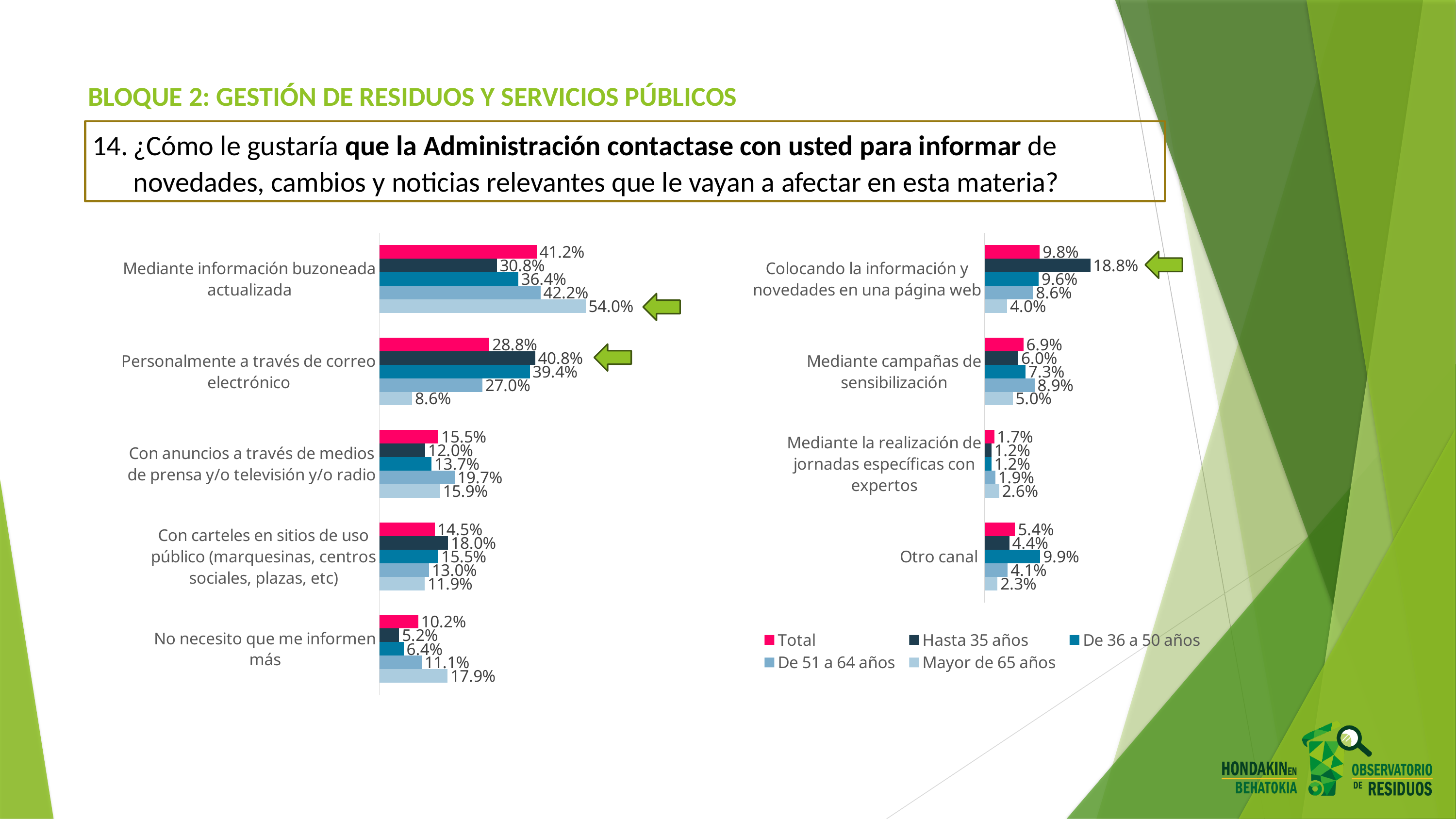
In the right chart, what is the 'Hasta 35 años' value for 'Colocando la información y novedades en una página web'? 18.8% How many series does the legend list? 5 In the left chart, what is the Total value for 'Mediante información buzoneada actualizada'? 41.2% In the left chart, which age group has the lowest value for 'No necesito que me informen más'? Hasta 35 años In the left chart, which age group has the highest value for 'Mediante información buzoneada actualizada'? Mayor de 65 años What kind of chart is the left chart? Bar chart In the left chart, which is larger for 'Personalmente a través de correo electrónico': the 'Hasta 35 años' value or the 'De 51 a 64 años' value? Hasta 35 años How many categories does the left chart show? 5 In the right chart, what is the Total value for 'Otro canal'? 5.4% How many categories does the right chart show? 4 In the left chart, what is the value for 'Mayor de 65 años' for 'Personalmente a través de correo electrónico'? 8.6% In the right chart, what is the difference between the 'Hasta 35 años' and 'Mayor de 65 años' values for 'Colocando la información y novedades en una página web'? 14.8%